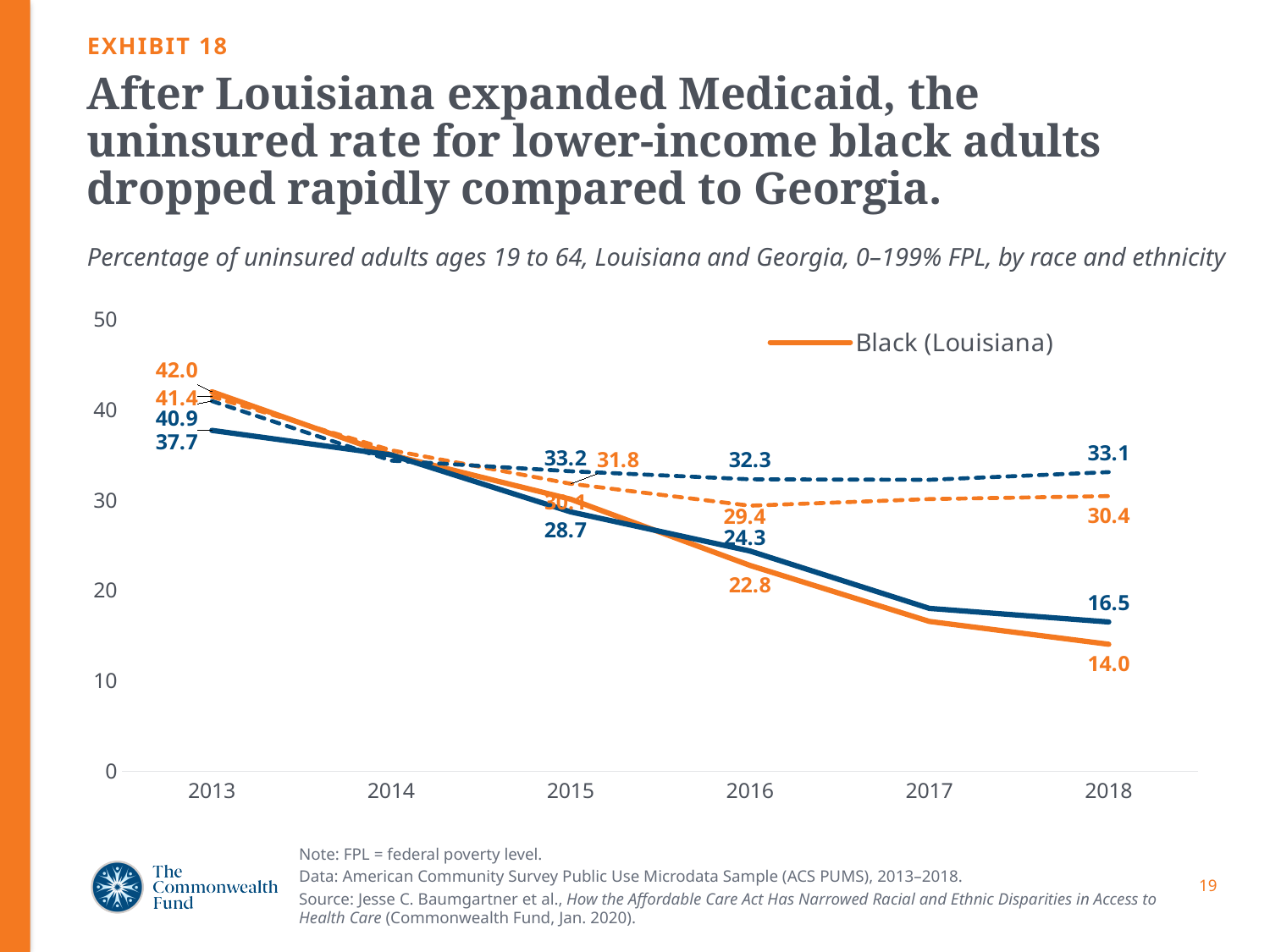
Is the value for Black (Louisiana) in 2017 greater or less than 20? less What is the value for Black (Louisiana) in 2016? 22.8 In which year is the Black (Louisiana) value lowest? 2018 How many years are shown on the x axis? 6 What kind of chart is shown on the slide? line chart In 2018, which is larger: the Black (Louisiana) value or the value of the solid dark blue line? the solid dark blue line What is the value for Black (Louisiana) in 2013? 42.0 By how much did the Black (Louisiana) value fall from 2013 to 2018? 28.0 What is the value for Black (Louisiana) in 2018? 14.0 Which series name is shown in the chart legend? Black (Louisiana) Does the Black (Louisiana) line rise or fall from 2013 to 2018? fall In which year is the Black (Louisiana) value highest? 2013